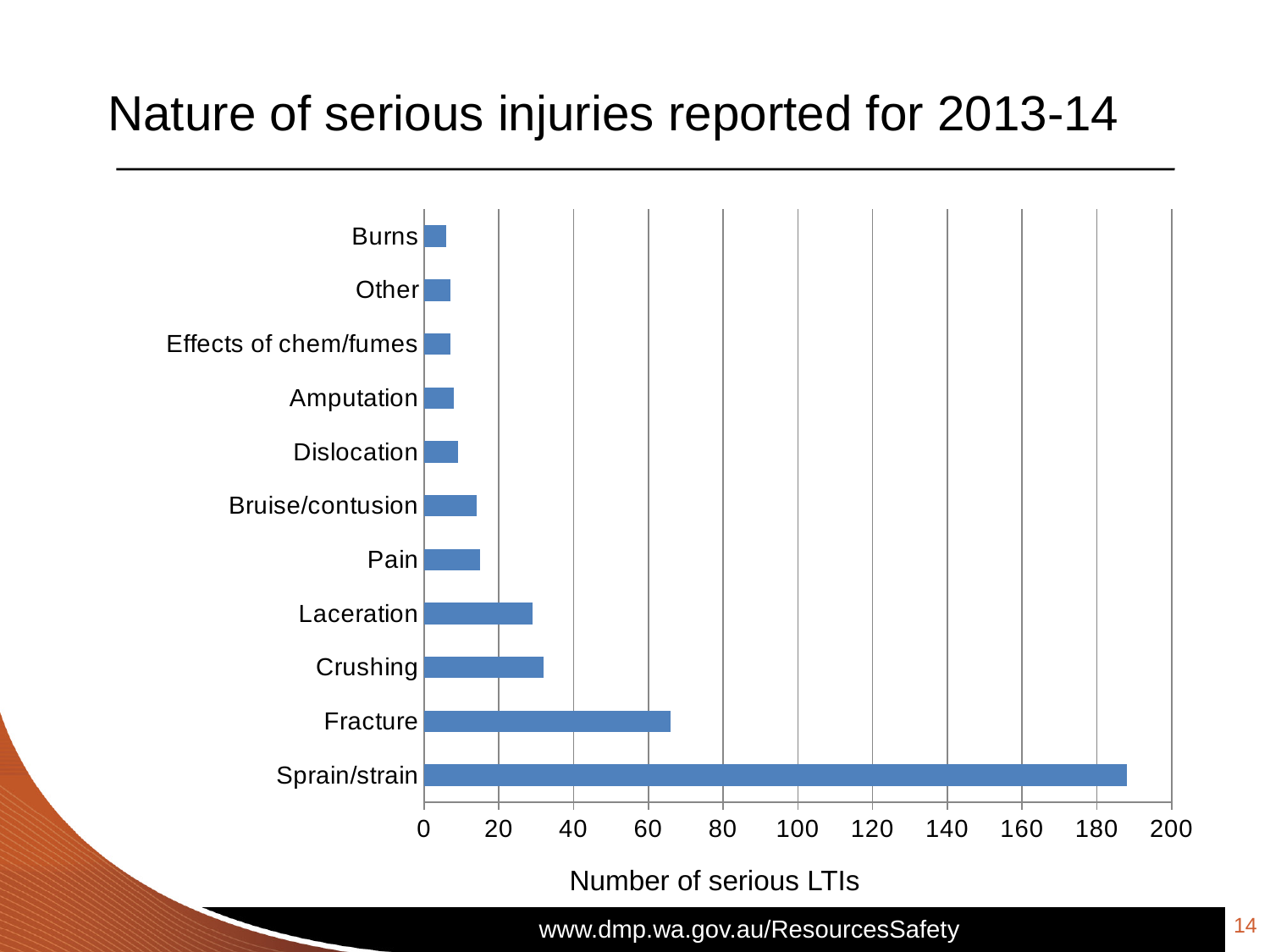
Is the value for Crushing greater or less than 40? less Is the value for Fracture greater or less than 60? greater What kind of chart is shown on the slide? bar chart How many injury categories are shown on the chart? 11 Is the value for Laceration greater or less than 20? greater Which has more serious LTIs, Fracture or Crushing? Fracture Which has more serious LTIs, Pain or Dislocation? Pain What is the label on the horizontal axis of the chart? Number of serious LTIs Which nature of injury has the highest number of serious LTIs? Sprain/strain